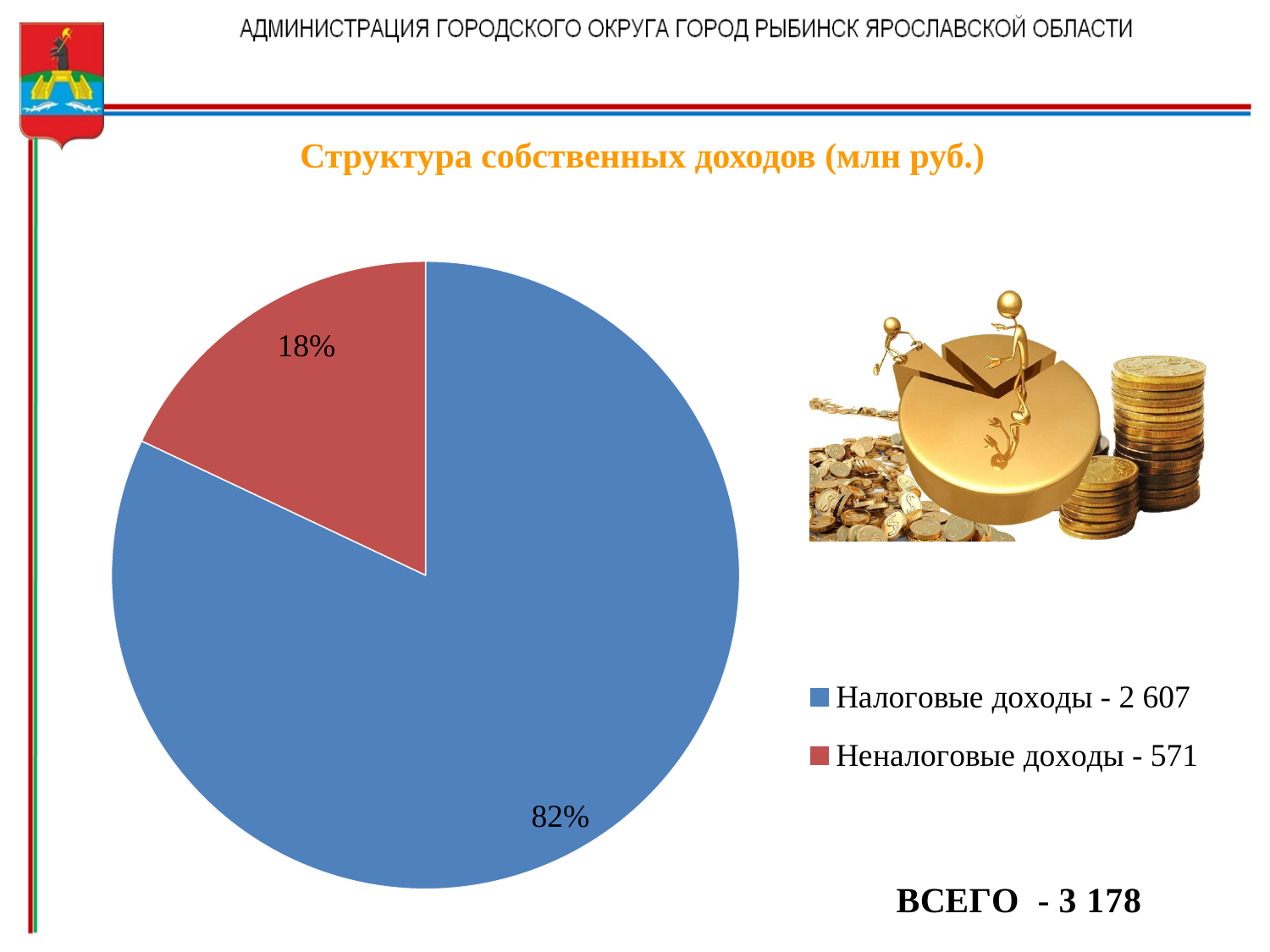
How many slices does the pie chart have? 2 What value does the legend give for Неналоговые доходы? 571 What share of the pie is labelled for Налоговые доходы? 82% What is the difference in percentage points between the Налоговые доходы and Неналоговые доходы slices? 64 What share of the pie is labelled for Неналоговые доходы? 18% Which category has the smallest slice of the pie? Неналоговые доходы How many entries does the legend list? 2 Which category has the largest slice of the pie? Налоговые доходы What kind of chart is shown on the slide? pie chart What total (ВСЕГО) is shown on the slide for own revenues? 3 178 What is the title of the chart? Структура собственных доходов (млн руб.) What value does the legend give for Налоговые доходы? 2 607